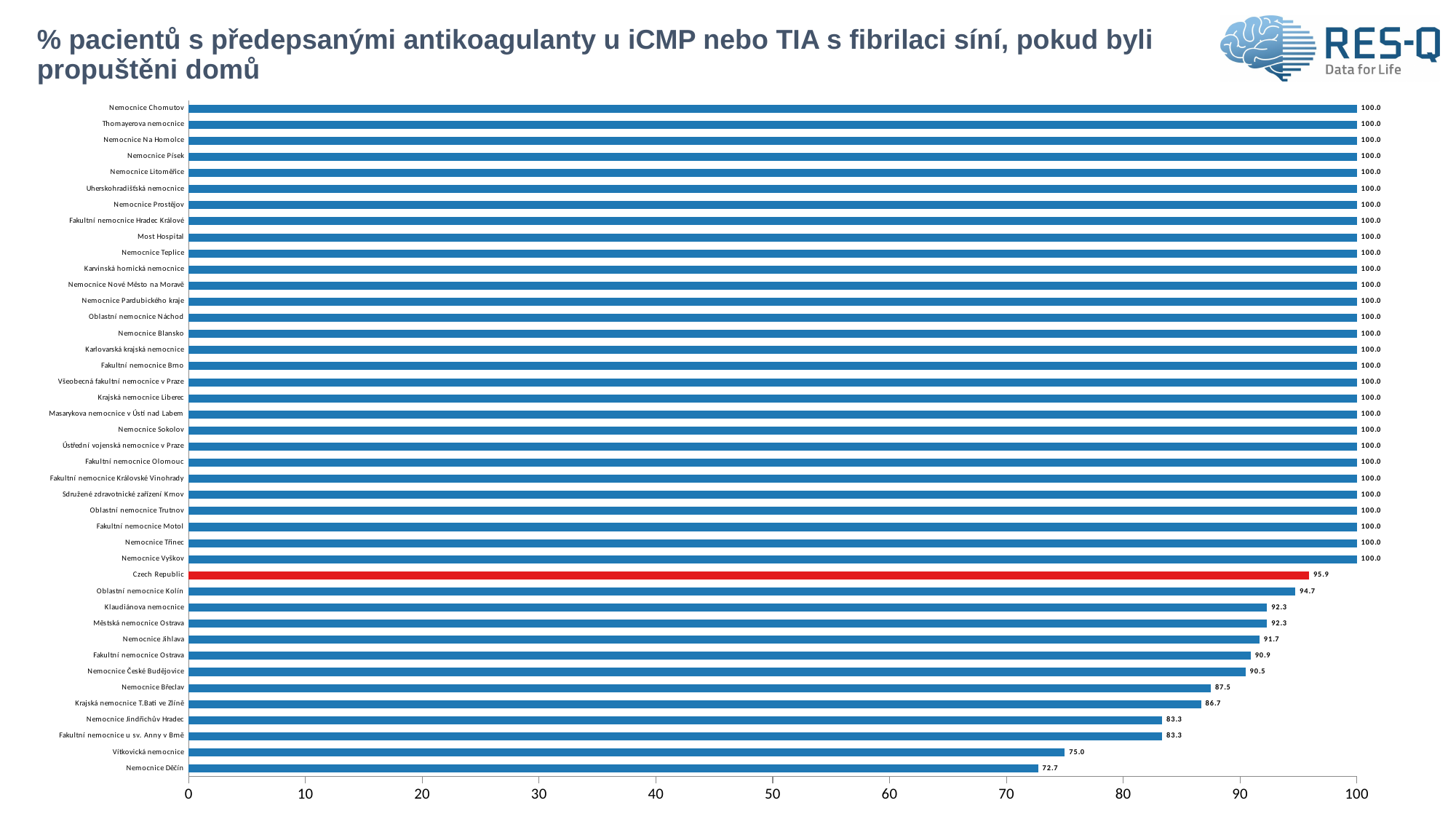
What is the value for Czech Republic? 95.9 What is the value for Nemocnice Děčín? 72.7 Which is larger, the value for Nemocnice Jihlava or the value for Fakultní nemocnice Ostrava? Nemocnice Jihlava Which hospital has the lowest value? Nemocnice Děčín Is the value for Krajská nemocnice T.Bati ve Zlíně greater or less than 90? less What is the value for Oblastní nemocnice Kolín? 94.7 Which bar is coloured red instead of blue? Czech Republic What kind of chart is shown on the slide? bar chart What is the difference between the values for Vítkovická nemocnice and Nemocnice Děčín? 2.3 How many bars are shown in the chart? 42 What is the value for Nemocnice Břeclav? 87.5 What is the difference between the values for Czech Republic and Nemocnice Děčín? 23.2